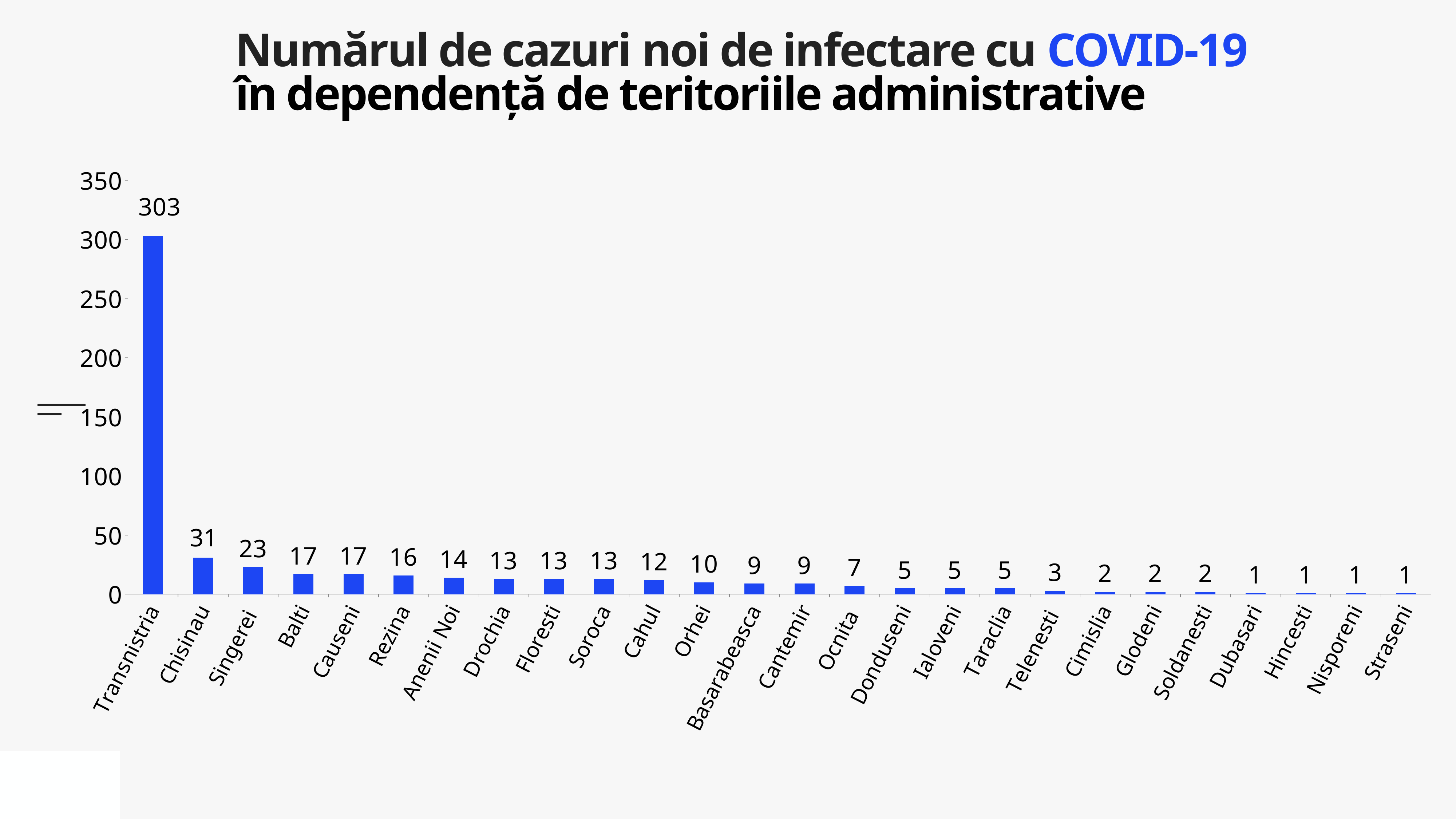
Do the values rise or fall from left to right along the x axis? Fall What is the difference between the values for Singerei and Balti? 6 Which administrative territory has the highest number of new cases? Transnistria Is the value for Transnistria greater or less than 300? greater What kind of chart is shown on the slide? Bar chart What is the value shown for Orhei? 10 What is the difference between the values for Transnistria and Chisinau? 272 What is the number of new COVID-19 cases for Transnistria? 303 What is the number of new COVID-19 cases for Chisinau? 31 What is the value shown for Singerei? 23 Which has a larger value, Rezina or Anenii Noi? Rezina How many administrative territories are shown on the x axis? 26